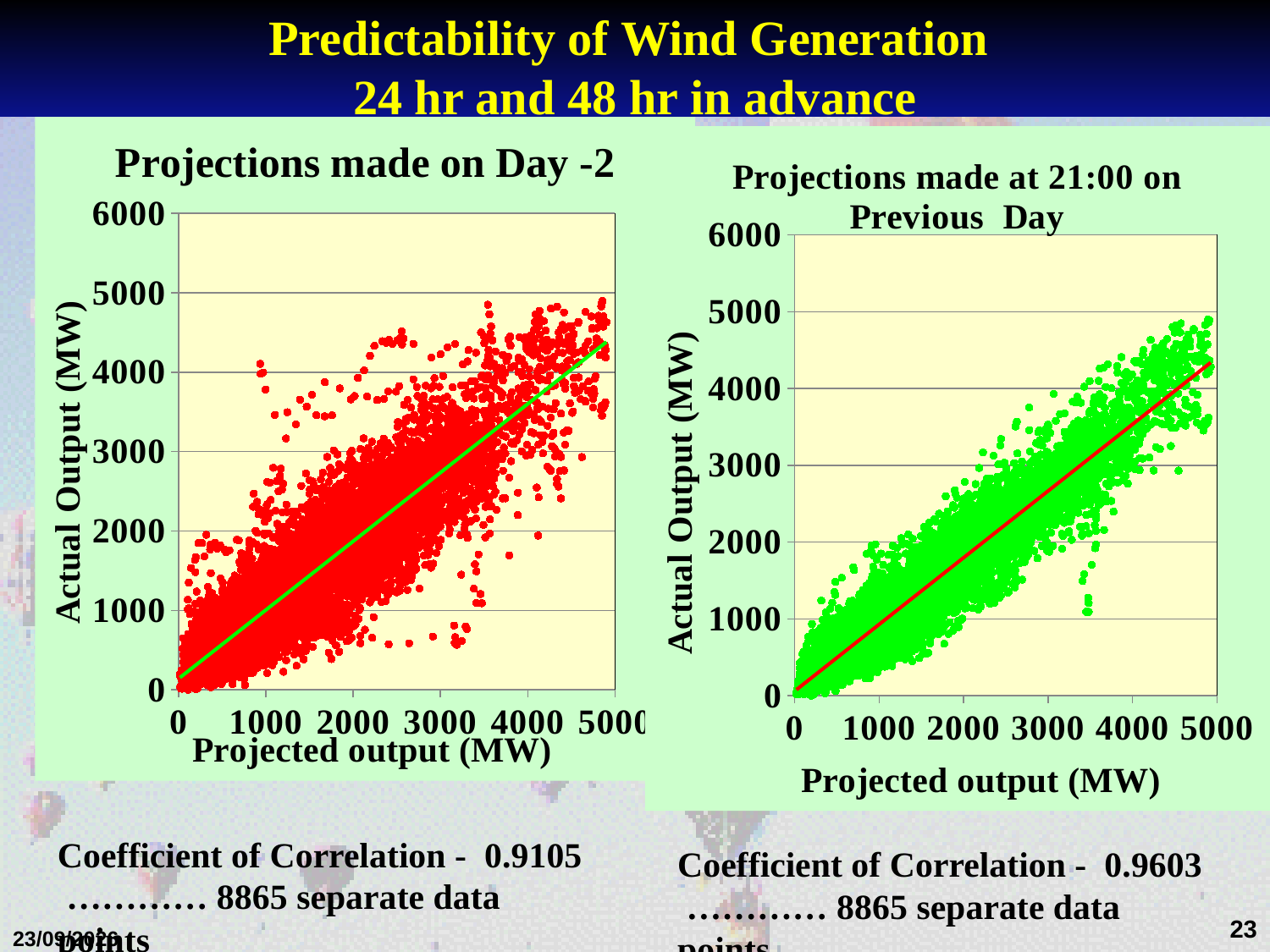
In the right chart 'Projections made at 21:00 on Previous Day', do the actual output values rise or fall as projected output increases along the x axis? rise In the left chart 'Projections made on Day -2', do the actual output values rise or fall as projected output increases along the x axis? rise What kind of chart is the right chart titled 'Projections made at 21:00 on Previous Day'? scatter chart In the right chart 'Projections made at 21:00 on Previous Day', is the highest plotted actual output value greater or less than 4000? greater What kind of chart is the left chart titled 'Projections made on Day -2'? scatter chart What is the title of the left chart on the slide? Projections made on Day -2 In the left chart 'Projections made on Day -2', is the highest plotted actual output value greater or less than 4000? greater What colour are the data points in the right chart 'Projections made at 21:00 on Previous Day'? green